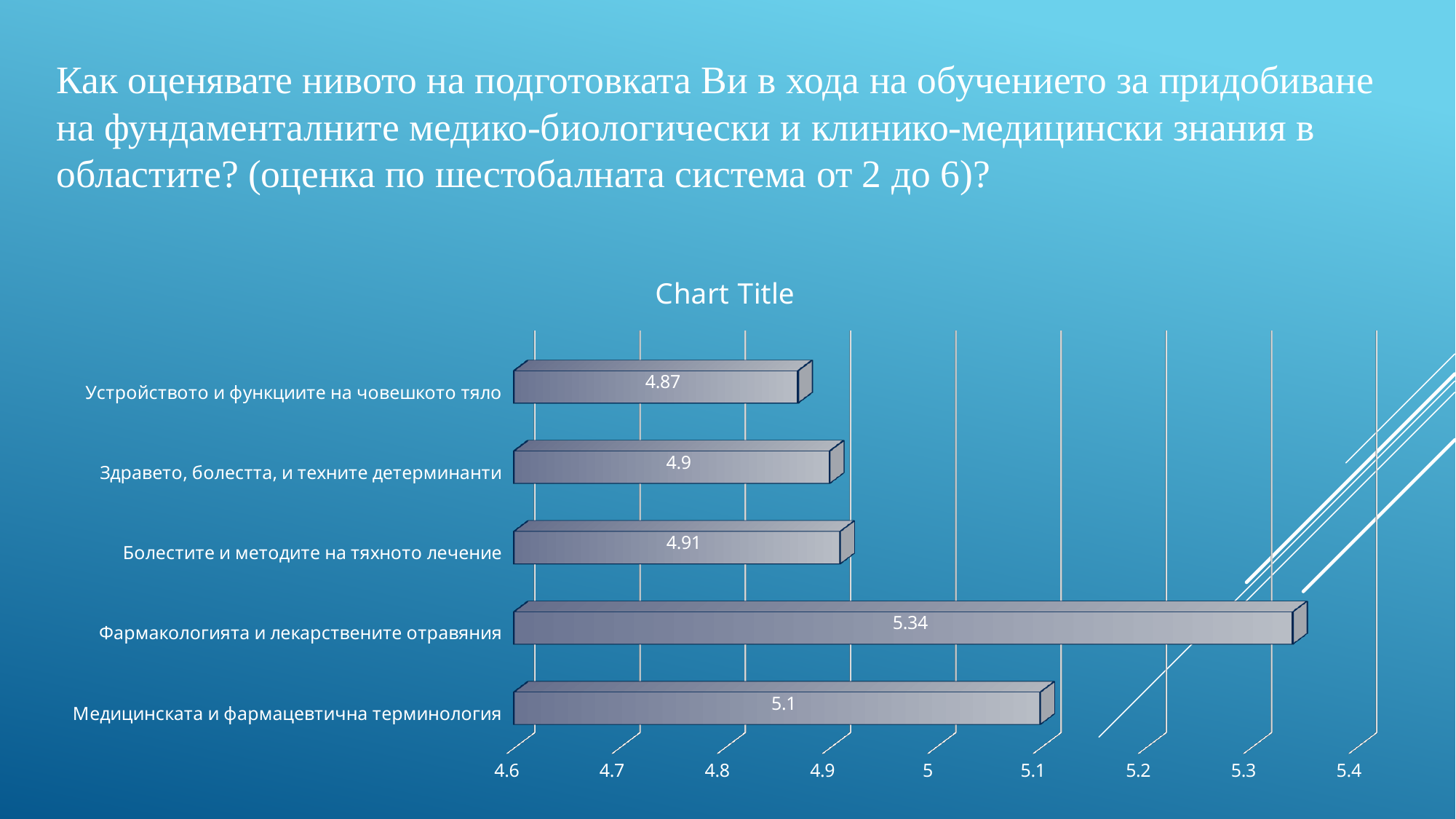
What kind of chart is shown on the slide? bar chart How many categories are shown in the chart? 5 Is the value for Медицинската и фармацевтична терминология greater or less than 5? greater Which is larger: the value for Болестите и методите на тяхното лечение or the value for Устройството и функциите на човешкото тяло? Болестите и методите на тяхното лечение What is the value for Устройството и функциите на човешкото тяло? 4.87 What is the value for Медицинската и фармацевтична терминология? 5.1 What is the value for Здравето, болестта, и техните детерминанти? 4.9 What is the value for Фармакологията и лекарствените отравяния? 5.34 What is the title of the chart? Chart Title Which category has the highest value? Фармакологията и лекарствените отравяния Which category has the lowest value? Устройството и функциите на човешкото тяло What is the difference between the values for Фармакологията и лекарствените отравяния and Медицинската и фармацевтична терминология? 0.24